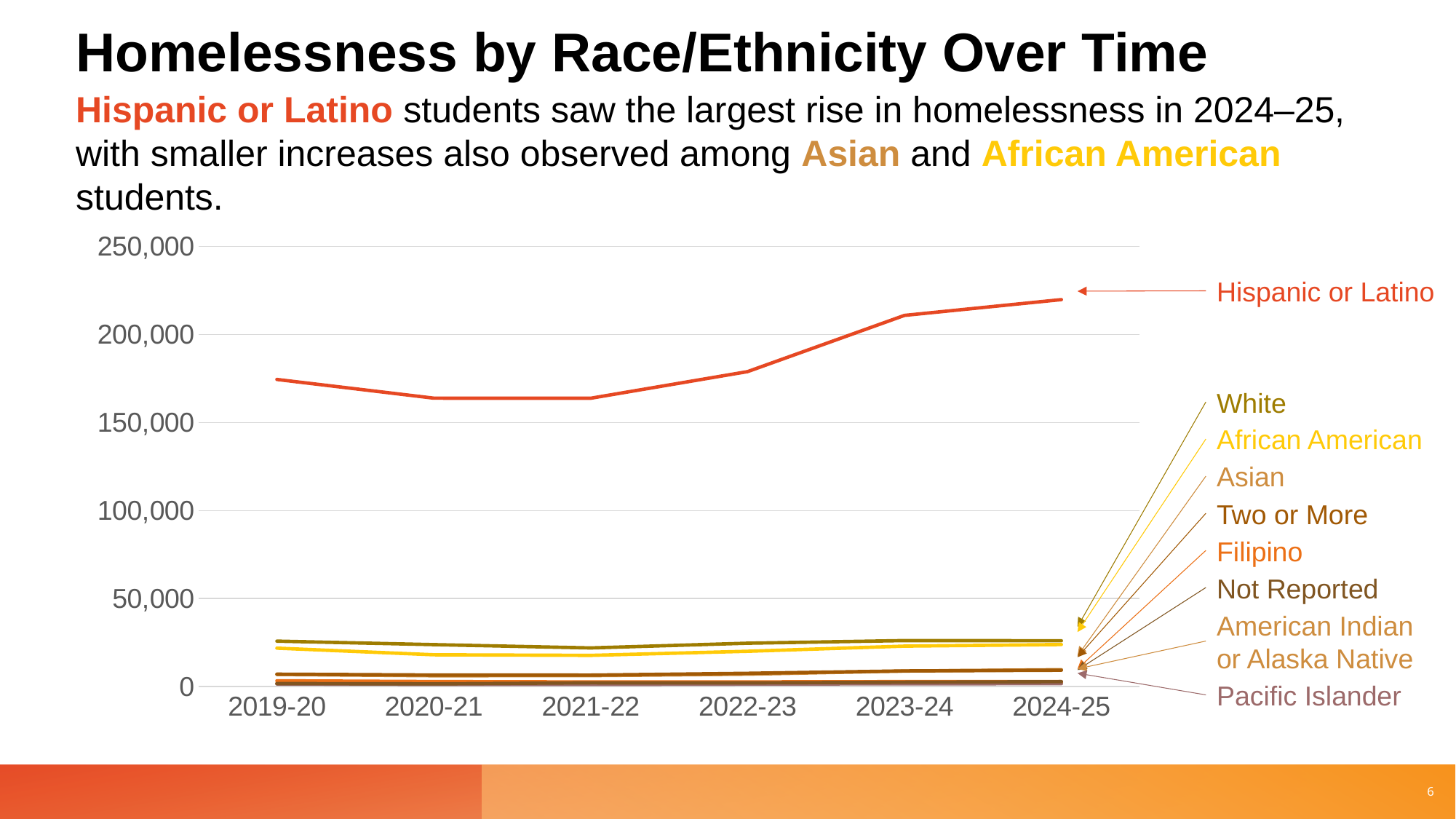
How many school years are plotted along the x axis? 6 Which is larger in 2024-25, the value for Hispanic or Latino or the value for White? Hispanic or Latino Which race/ethnicity group has the highest homelessness count in 2024-25? Hispanic or Latino Does the Hispanic or Latino line rise or fall from 2021-22 to 2024-25? rise Is the value for Hispanic or Latino in 2020-21 greater or less than 200,000? less Which series is drawn in red on the chart? Hispanic or Latino Is the value for Hispanic or Latino in 2024-25 greater or less than 200,000? greater What is the title of the slide's chart? Homelessness by Race/Ethnicity Over Time How many race/ethnicity series are labelled on the chart? 9 Is the value for White in 2024-25 greater or less than 50,000? less What kind of chart is shown on the slide? line chart